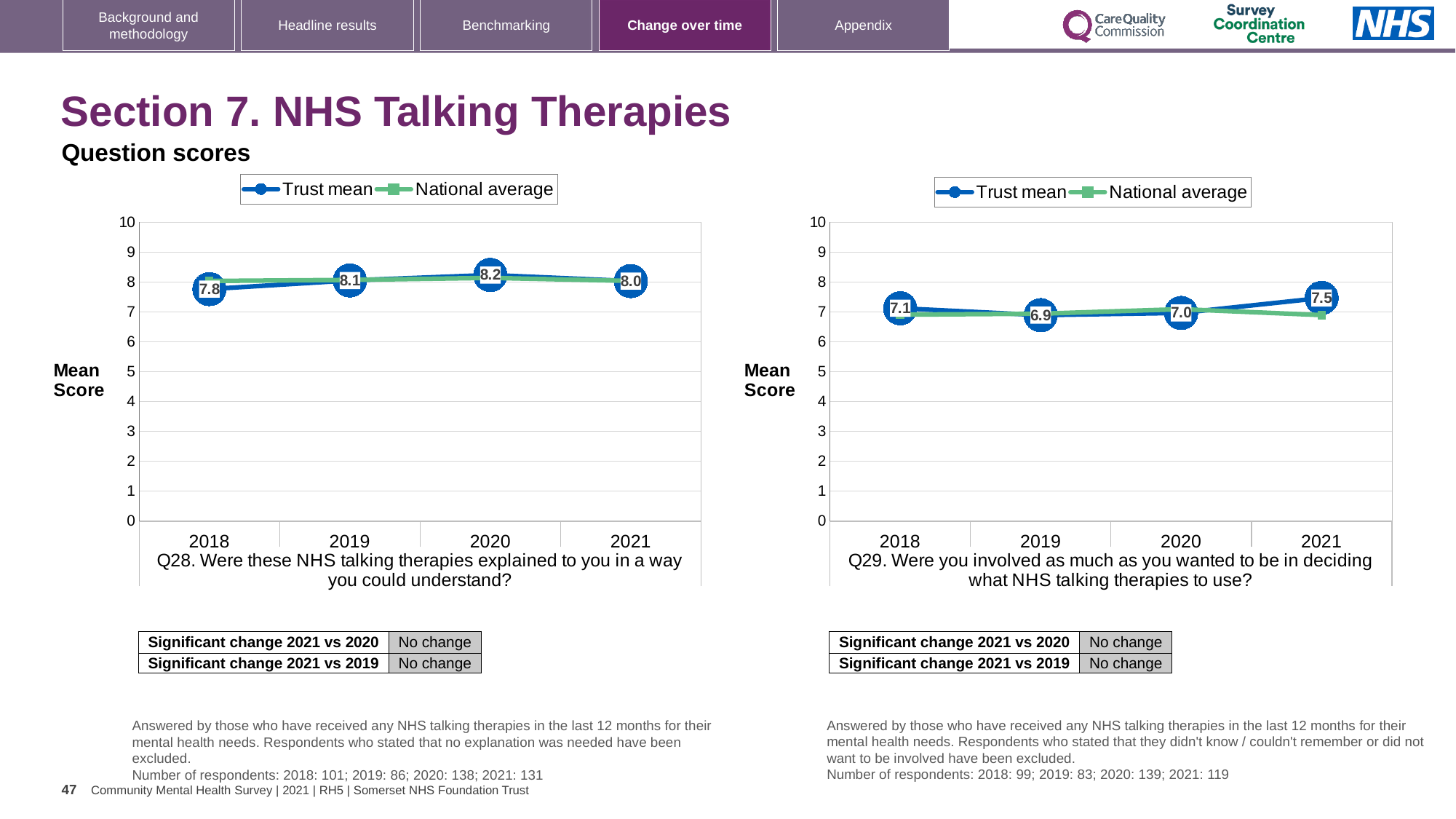
What kind of chart is the Q28 chart (left)? Line chart In the Q28 chart (left), is the Trust mean for 2019 or for 2021 larger? 2019 In the Q28 chart (left), what is the Trust mean for 2018? 7.8 In the Q29 chart (right), what is the Trust mean for 2019? 6.9 In the Q29 chart (right), what is the difference between the Trust mean in 2021 and in 2018? 0.4 How many years are plotted on the x axis of the Q28 chart (left)? 4 In the Q28 chart (left), what is the Trust mean for 2020? 8.2 In the Q28 chart (left), which year has the highest Trust mean? 2020 In the Q29 chart (right), what is the Trust mean for 2021? 7.5 In the Q29 chart (right), which year has the lowest Trust mean? 2019 How many series does the legend of the Q29 chart (right) list? 2